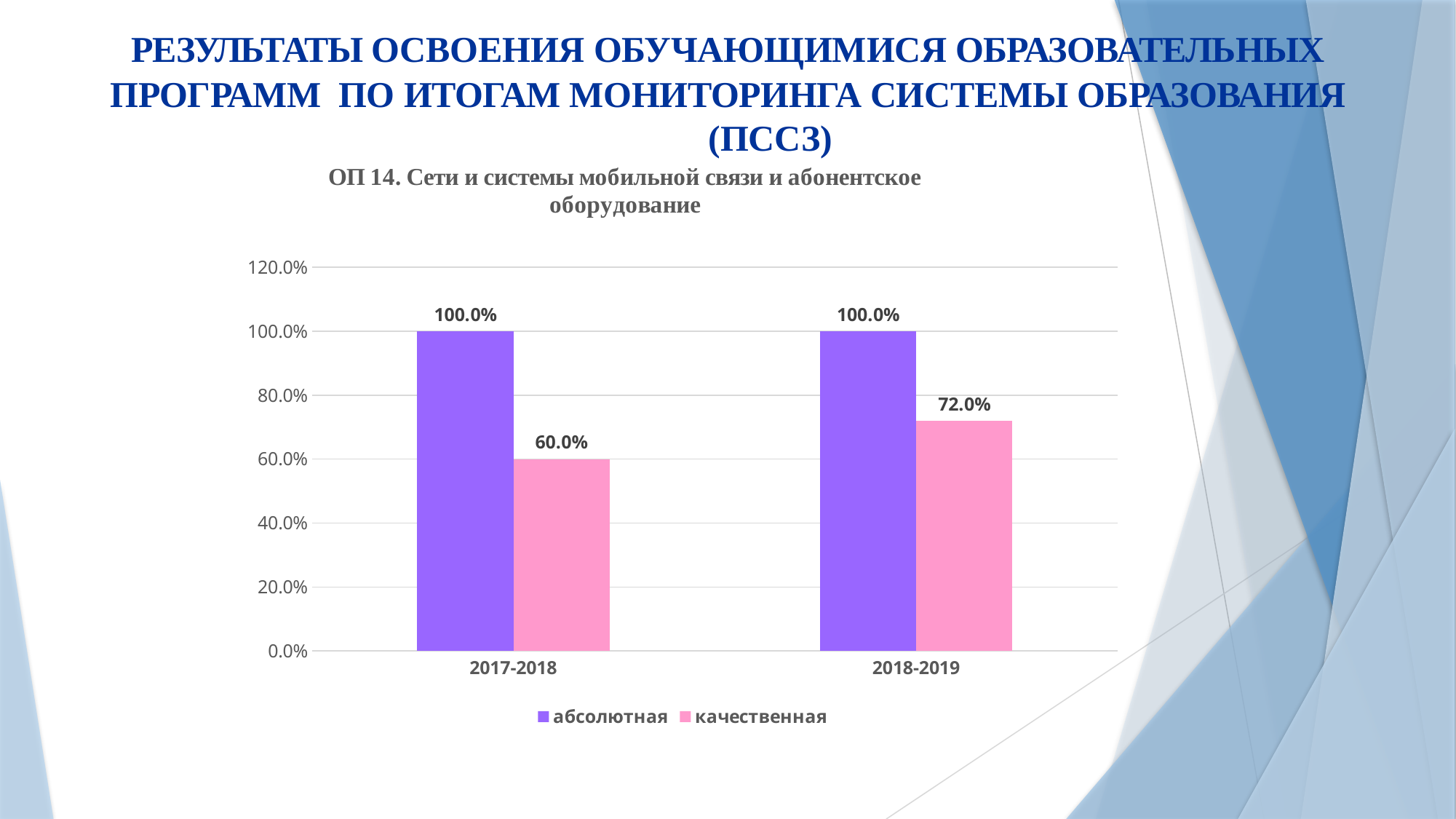
What kind of chart is shown on the slide? bar chart What is the value of the качественная series for 2017-2018? 60.0% In which year is the качественная value lowest? 2017-2018 What is the value of the качественная series for 2018-2019? 72.0% What is the difference between the абсолютная and качественная values for 2017-2018? 40.0% What is the difference between the качественная values for 2018-2019 and 2017-2018? 12.0% What is the value of the абсолютная series for 2018-2019? 100.0% What is the value of the абсолютная series for 2017-2018? 100.0% Which is larger for 2018-2019: абсолютная or качественная? абсолютная How many categories are shown on the x axis? 2 In which year is the качественная value highest? 2018-2019 How many series does the legend list? 2